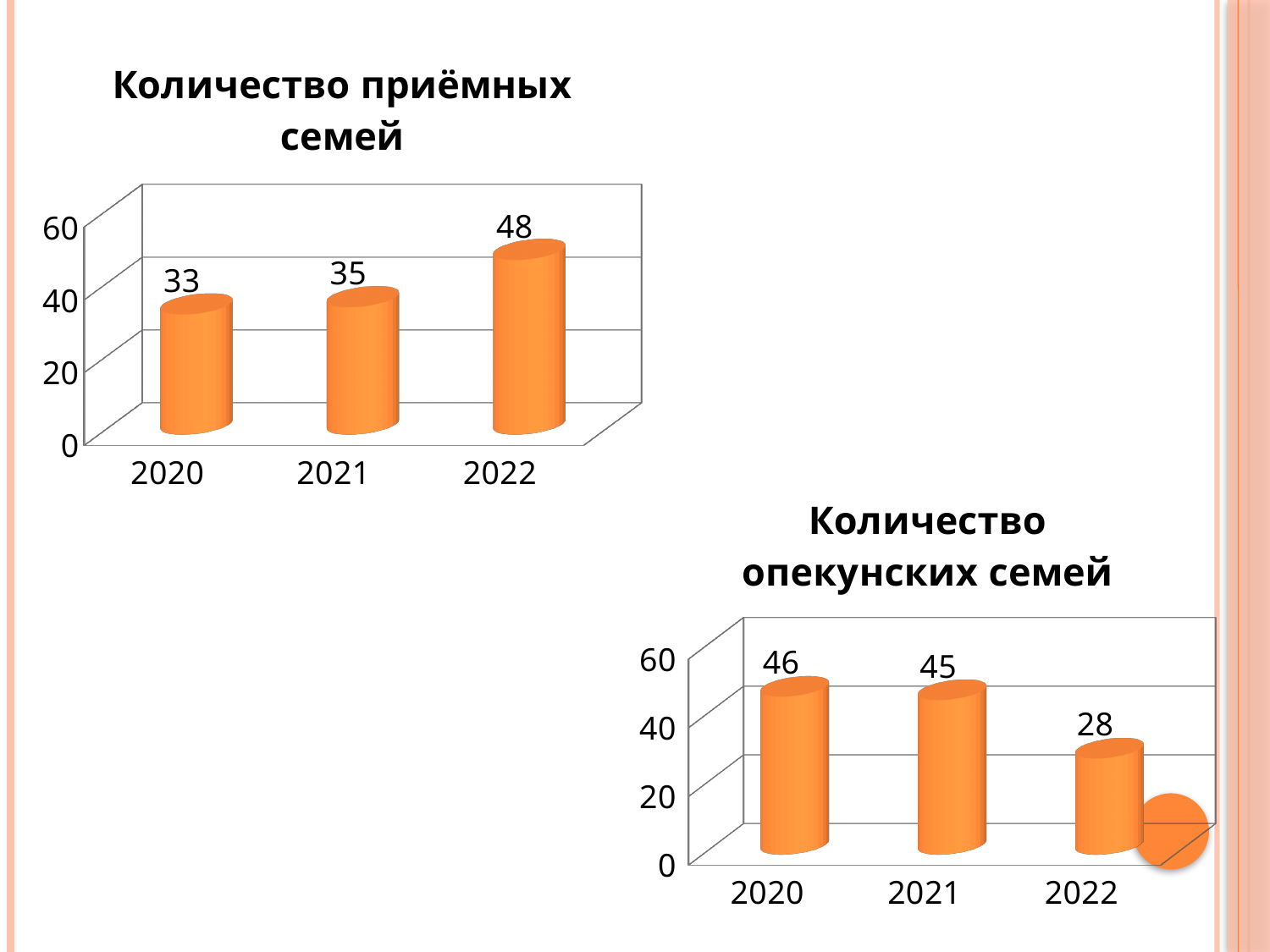
In the chart titled 'Количество опекунских семей', what is the value for 2021? 45 In the chart titled 'Количество приёмных семей', is the value for 2022 greater or less than 40? greater In the chart titled 'Количество опекунских семей', which is larger: the value for 2020 or the value for 2022? 2020 In the chart titled 'Количество приёмных семей', do the values rise or fall from 2020 to 2022? rise In the chart titled 'Количество приёмных семей', what is the value for 2022? 48 What kind of chart is the chart titled 'Количество опекунских семей'? bar chart In the chart titled 'Количество приёмных семей', what is the difference between the values for 2022 and 2020? 15 In the chart titled 'Количество приёмных семей', which year has the highest value? 2022 In the chart titled 'Количество опекунских семей', what is the difference between the values for 2020 and 2022? 18 In the chart titled 'Количество опекунских семей', do the values rise or fall from 2020 to 2022? fall How many years are shown on the x axis of the chart titled 'Количество приёмных семей'? 3 In the chart titled 'Количество опекунских семей', which year has the lowest value? 2022